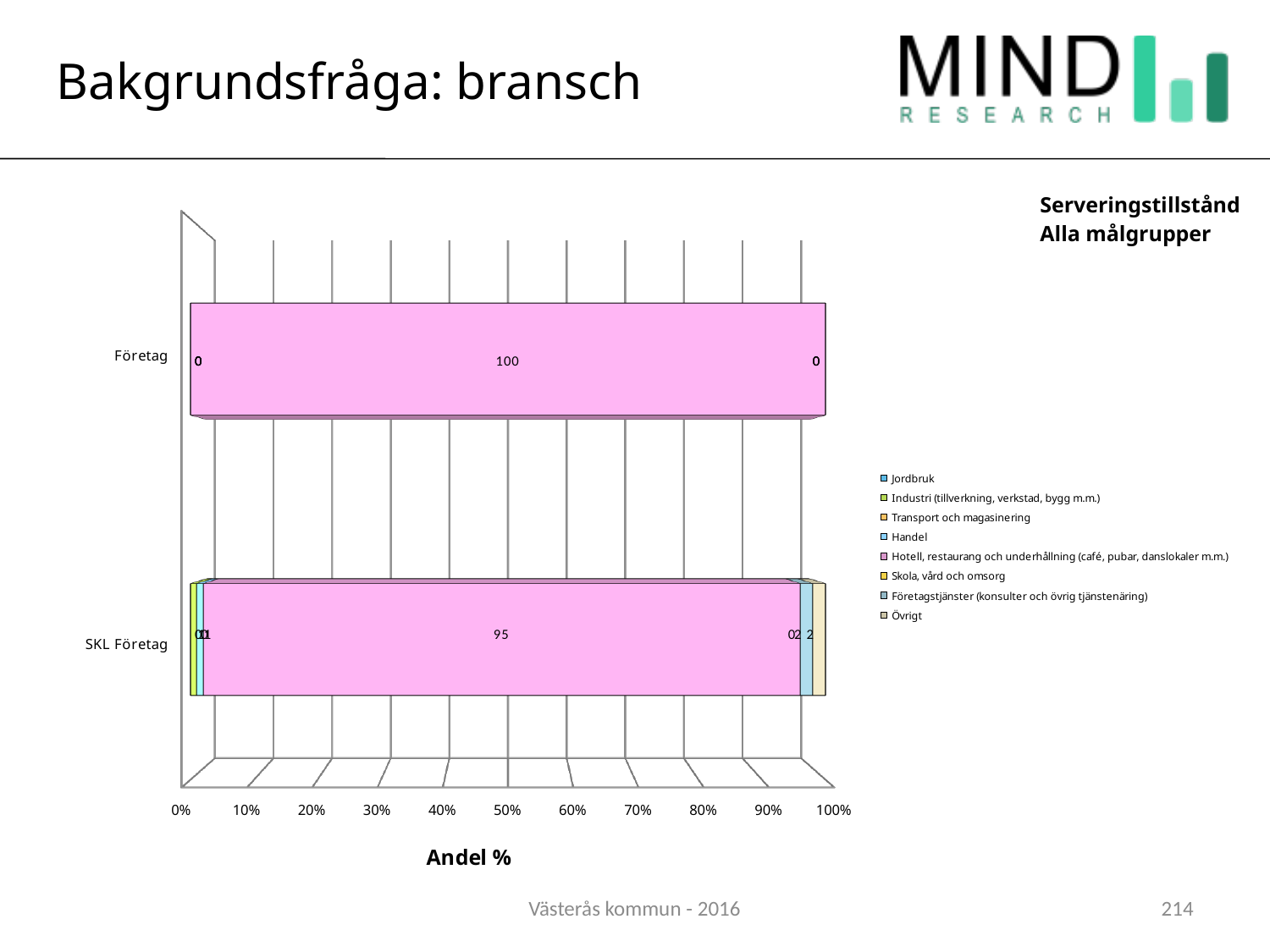
Which category has the highest value for 'Hotell, restaurang och underhållning'? Företag What is the value for 'Hotell, restaurang och underhållning' in the Företag bar? 100 Which category has the larger value for 'Hotell, restaurang och underhållning', Företag or SKL Företag? Företag What is the difference between the 'Hotell, restaurang och underhållning' values for Företag and SKL Företag? 5 What kind of chart is shown on the slide? bar chart How many series does the chart's legend list? 8 What is the title of the horizontal axis? Andel % Is the 'Hotell, restaurang och underhållning' value for SKL Företag greater or less than 90%? greater What is the value for 'Hotell, restaurang och underhållning' in the SKL Företag bar? 95 How many categories are shown on the vertical axis of the chart? 2 What is the last entry listed in the chart's legend? Övrigt